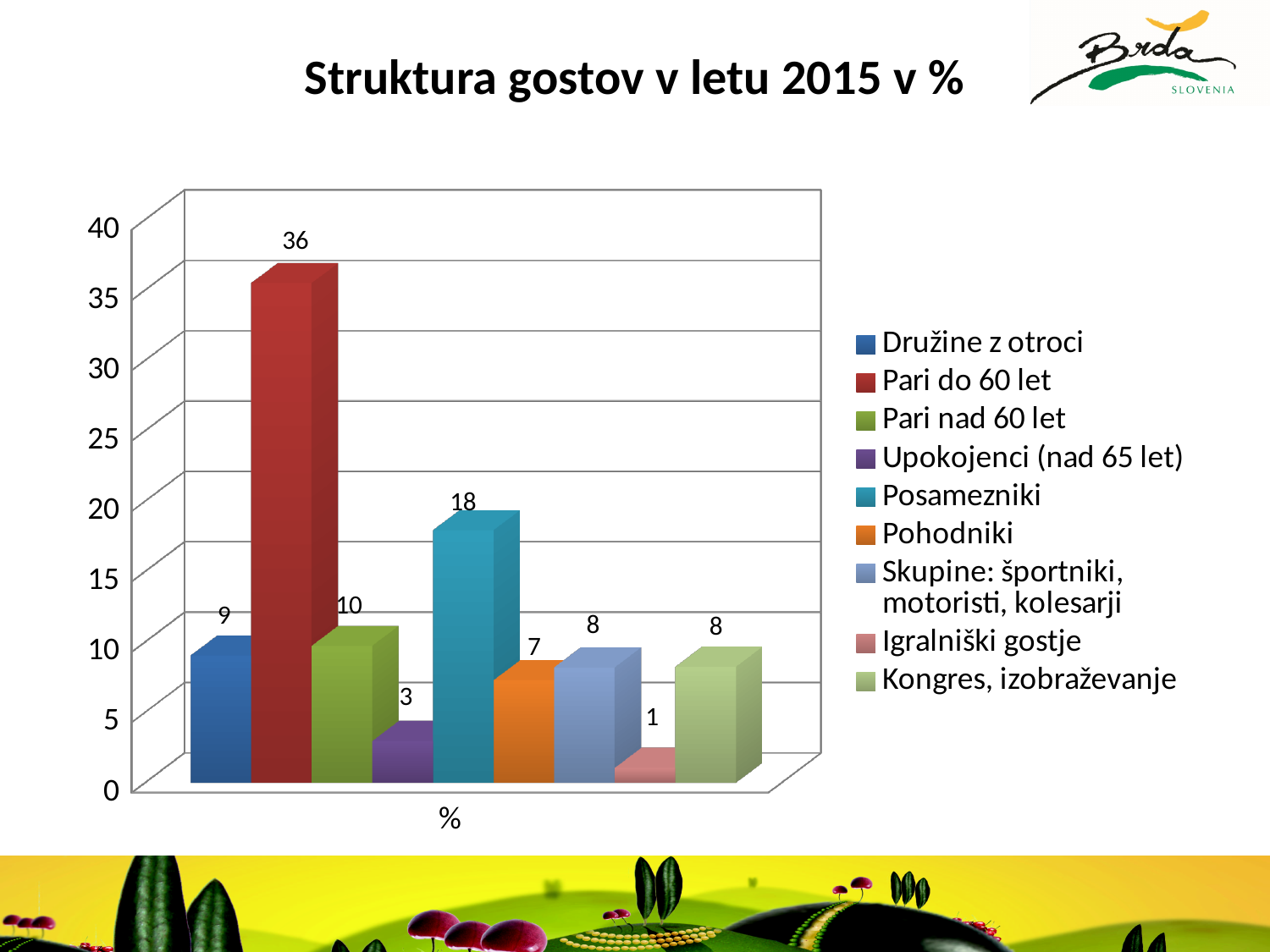
Which series has the lowest value? Igralniški gostje What is the title of the chart? Struktura gostov v letu 2015 v % Which is larger, the value for Družine z otroci or the value for Pari nad 60 let? Pari nad 60 let Which series has the highest value? Pari do 60 let What kind of chart is shown on the slide? Bar chart How many series does the legend list? 9 What is the difference between the values for Pari do 60 let and Posamezniki? 18 What is the value for Posamezniki? 18 What is the value for Pari do 60 let? 36 What is the value for Upokojenci (nad 65 let)? 3 What is the difference between the values for Pohodniki and Igralniški gostje? 6 What is the value for Igralniški gostje? 1